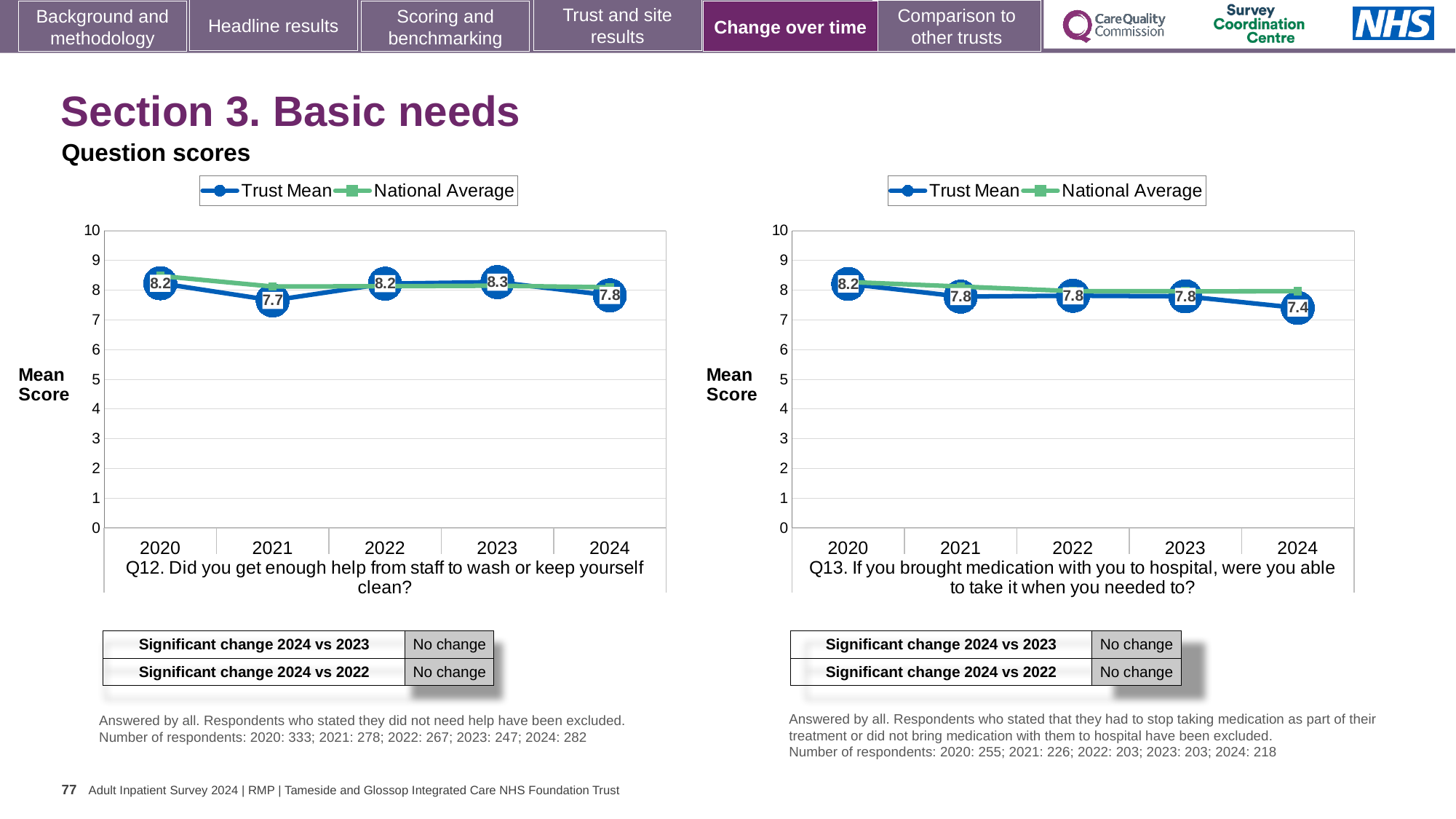
How many series does the legend of the Q12 chart (left) list? 2 On the Q12 chart (left), what is the difference between the Trust Mean scores for 2023 and 2024? 0.5 On the Q13 chart (right), which year has the lowest Trust Mean score? 2024 What type of chart is used for the Q13 chart (right)? Line chart On the Q13 chart (right), how many years are shown on the x axis? 5 On the Q13 chart (right), is the Trust Mean score for 2020 larger or smaller than the score for 2024? larger On the Q12 chart (left), what is the Trust Mean score for 2021? 7.7 On the Q12 chart (left), what is the Trust Mean score for 2023? 8.3 On the Q13 chart (right), what is the Trust Mean score for 2024? 7.4 On the Q12 chart (left), which year has the highest Trust Mean score? 2023 On the Q13 chart (right), what is the Trust Mean score for 2020? 8.2 On the Q12 chart (left), which year has the lowest Trust Mean score? 2021